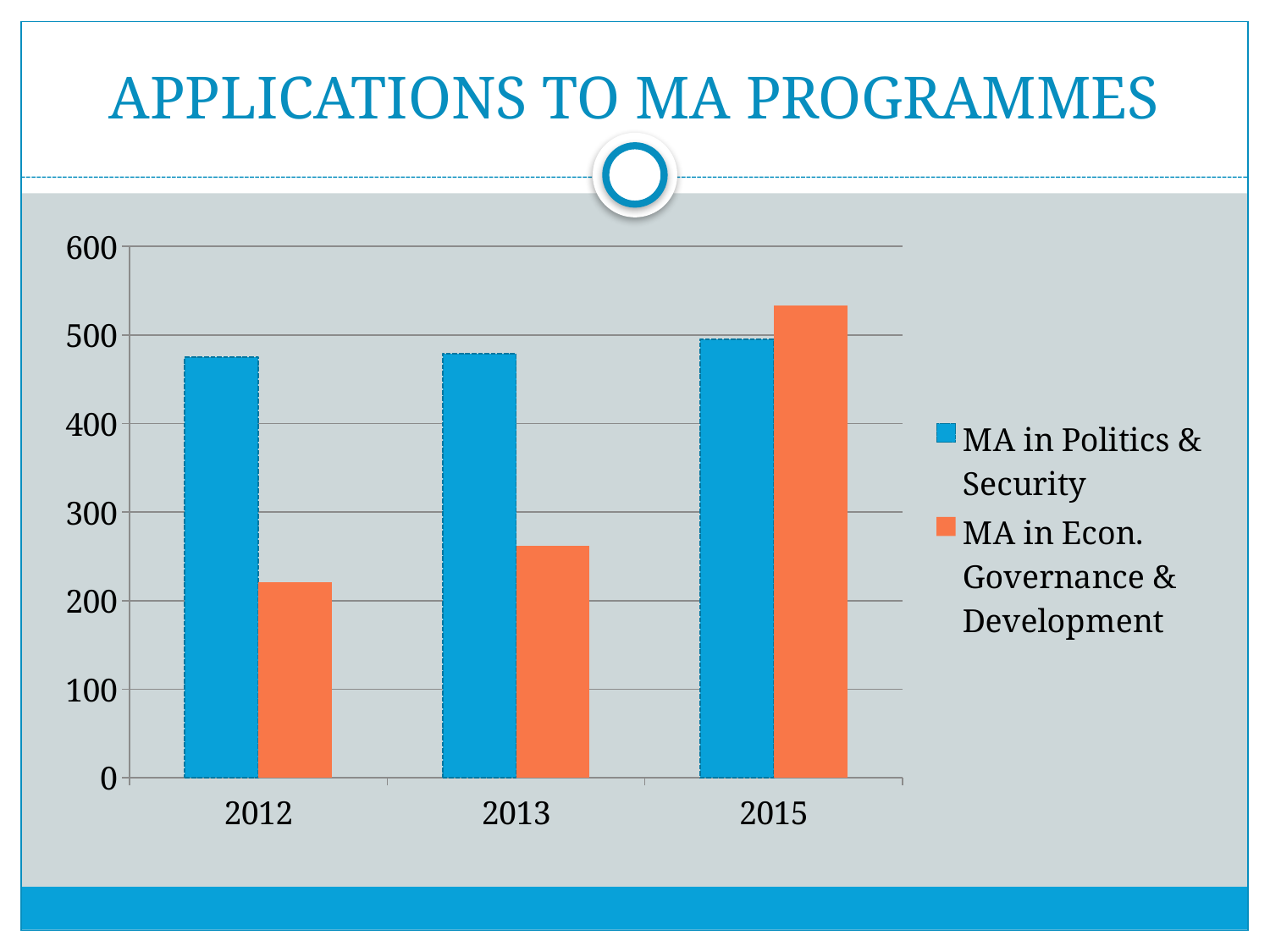
In which year is the value for MA in Econ. Governance & Development highest? 2015 Is the value for MA in Econ. Governance & Development in 2012 greater or less than 300? less Which colour represents MA in Econ. Governance & Development in the chart? orange Do the values for MA in Econ. Governance & Development rise or fall from 2012 to 2015? rise In 2012, which series has the larger value: MA in Politics & Security or MA in Econ. Governance & Development? MA in Politics & Security Is the value for MA in Econ. Governance & Development in 2015 greater or less than 500? greater What is the title of the slide containing the chart? APPLICATIONS TO MA PROGRAMMES What kind of chart is shown on the slide? bar chart In 2015, which series has the larger value: MA in Politics & Security or MA in Econ. Governance & Development? MA in Econ. Governance & Development Is the value for MA in Politics & Security in 2013 greater or less than 400? greater How many years are shown on the x axis of the chart? 3 How many series does the legend list? 2